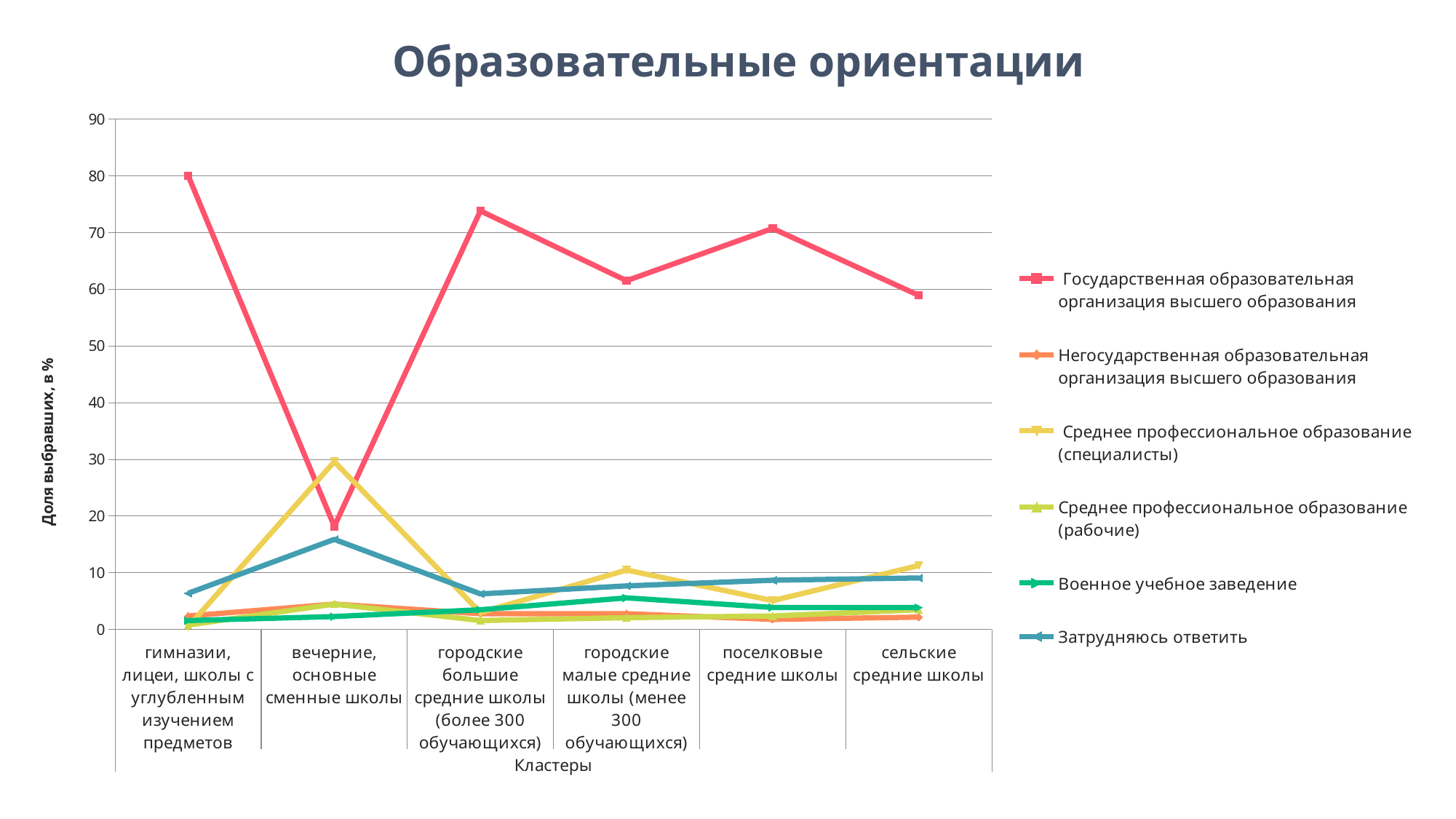
What kind of chart is shown on the slide? line chart What is the title of the vertical axis? Доля выбравших, в % For the series 'Государственная образовательная организация высшего образования', which cluster has the lowest value? вечерние, основные сменные школы For the series 'Затрудняюсь ответить', which cluster has the highest value? вечерние, основные сменные школы Is the value for 'Среднее профессиональное образование (специалисты)' at 'вечерние, основные сменные школы' greater or less than 20? greater How many series does the legend list? 6 Does the value for 'Государственная образовательная организация высшего образования' rise or fall from 'городские большие средние школы (более 300 обучающихся)' to 'городские малые средние школы (менее 300 обучающихся)'? fall Is the value for 'Государственная образовательная организация высшего образования' at 'гимназии, лицеи, школы с углубленным изучением предметов' greater or less than 70? greater Is the value for 'Государственная образовательная организация высшего образования' at 'вечерние, основные сменные школы' greater or less than 30? less At 'вечерние, основные сменные школы', which is larger: 'Среднее профессиональное образование (специалисты)' or 'Затрудняюсь ответить'? Среднее профессиональное образование (специалисты) How many clusters (categories) are shown along the x axis? 6 For the series 'Государственная образовательная организация высшего образования', which cluster has the highest value? гимназии, лицеи, школы с углубленным изучением предметов